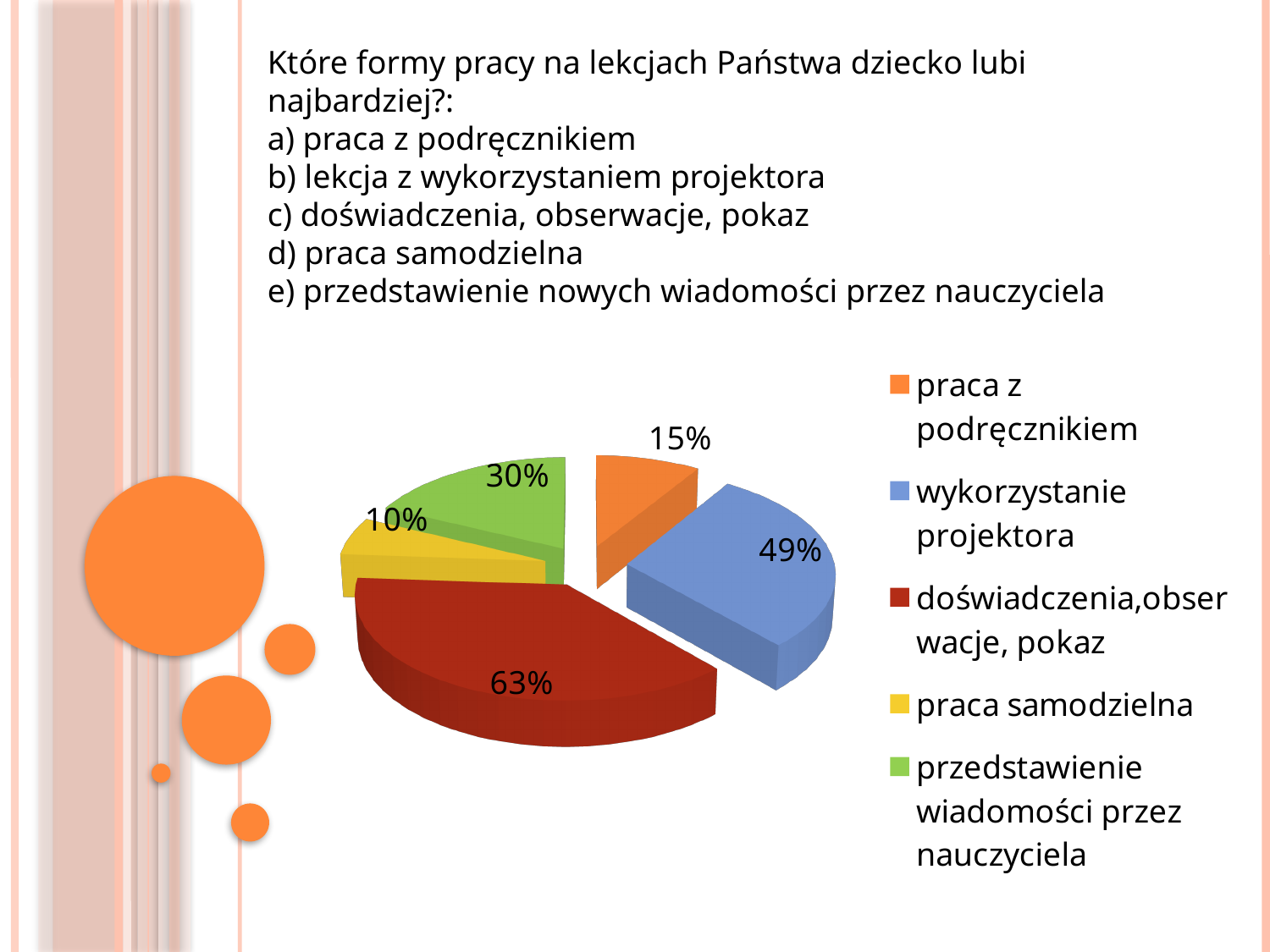
How many categories does the pie chart have? 5 What value is shown for "praca z podręcznikiem"? 15% What kind of chart is shown on the slide? pie chart What value is shown for "doświadczenia, obserwacje, pokaz"? 63% What is the difference between the values for "doświadczenia, obserwacje, pokaz" and "wykorzystanie projektora"? 14% What value is shown for "praca samodzielna"? 10% Which category has the highest value in the pie chart? doświadczenia, obserwacje, pokaz What value is shown for "przedstawienie wiadomości przez nauczyciela"? 30% Which is larger: the value for "przedstawienie wiadomości przez nauczyciela" or the value for "praca z podręcznikiem"? przedstawienie wiadomości przez nauczyciela What value is shown for "wykorzystanie projektora"? 49% Which category has the lowest value in the pie chart? praca samodzielna What colour is the slice for "praca samodzielna"? yellow